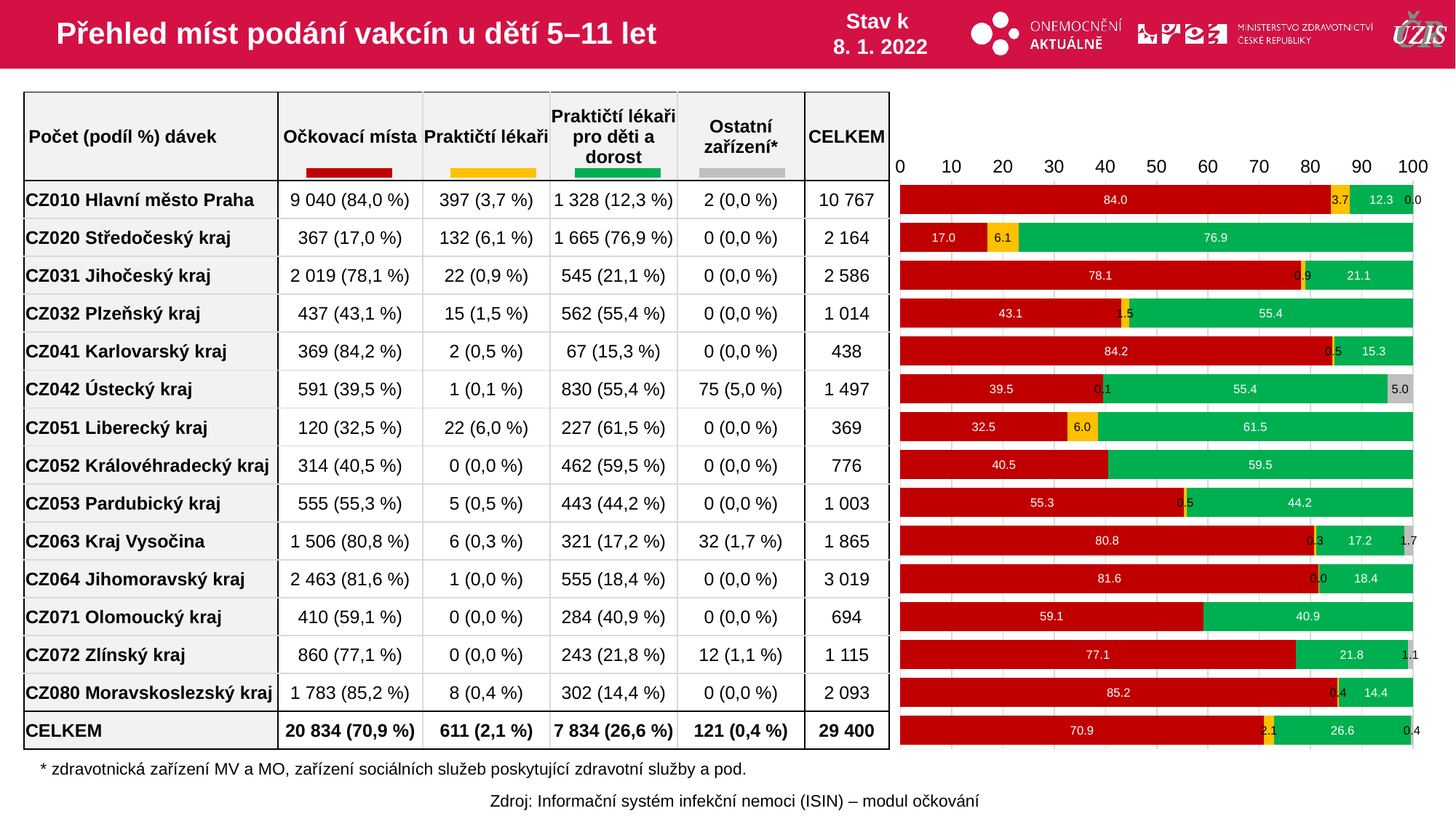
In the bar chart, what is the difference between the green and red segment values for CZ032 Plzeňský kraj? 12.3 What kind of chart is shown on the right side of the slide? Stacked bar chart How many bars (regions including CELKEM) are plotted in the bar chart? 15 In the bar chart, for CZ071 Olomoucký kraj, is the red segment or the green segment larger? Red segment In the bar chart, what is the value of the green (Praktičtí lékaři pro děti a dorost) segment for CZ020 Středočeský kraj? 76.9 How many series (colours) are shown in the stacked bar chart? 4 In the bar chart, what is the value of the green segment for the CELKEM bar? 26.6 In the bar chart, what is the value of the grey (Ostatní zařízení) segment for CZ042 Ústecký kraj? 5.0 What colour represents the Praktičtí lékaři series in the bar chart? Yellow In the bar chart, which region has the smallest red (Očkovací místa) segment? CZ020 Středočeský kraj In the bar chart, which region has the largest red (Očkovací místa) segment? CZ080 Moravskoslezský kraj In the bar chart, what is the value of the red (Očkovací místa) segment for CZ010 Hlavní město Praha? 84.0